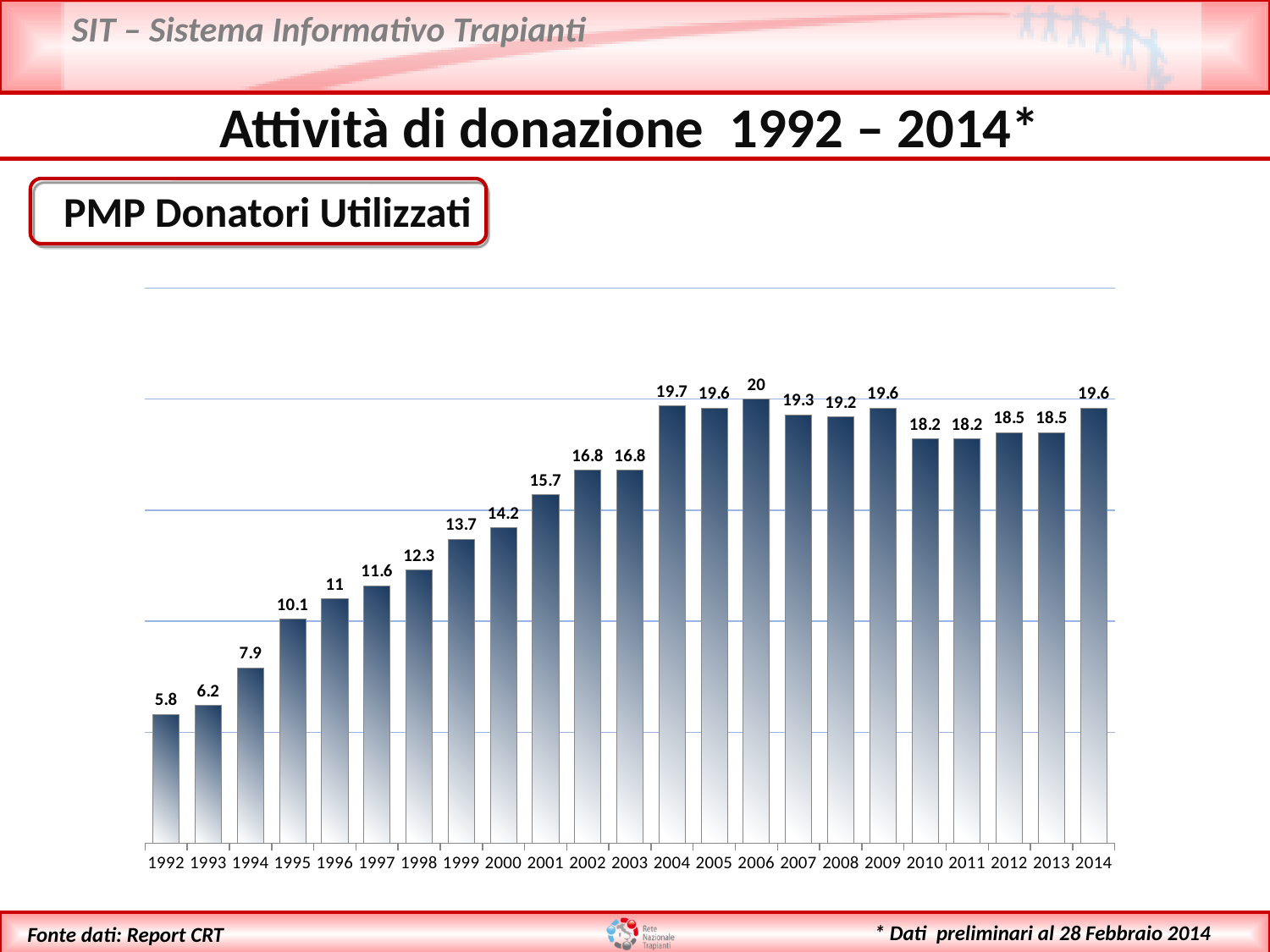
What is the difference between the values for 2012 and 2011? 0.3 How many years are shown on the x axis? 23 Which year has the lowest value? 1992 Which year has the highest value? 2006 What is the value shown for 2014? 19.6 What is the PMP Donatori Utilizzati value for 1992? 5.8 What is the value shown for 1999? 13.7 What is the difference between the values for 2006 and 1992? 14.2 What kind of chart is shown on the slide? bar chart What is the value shown for 2006? 20 Which is larger, the value for 2004 or the value for 2010? 2004 Do the values generally rise or fall from 1992 to 2006? rise